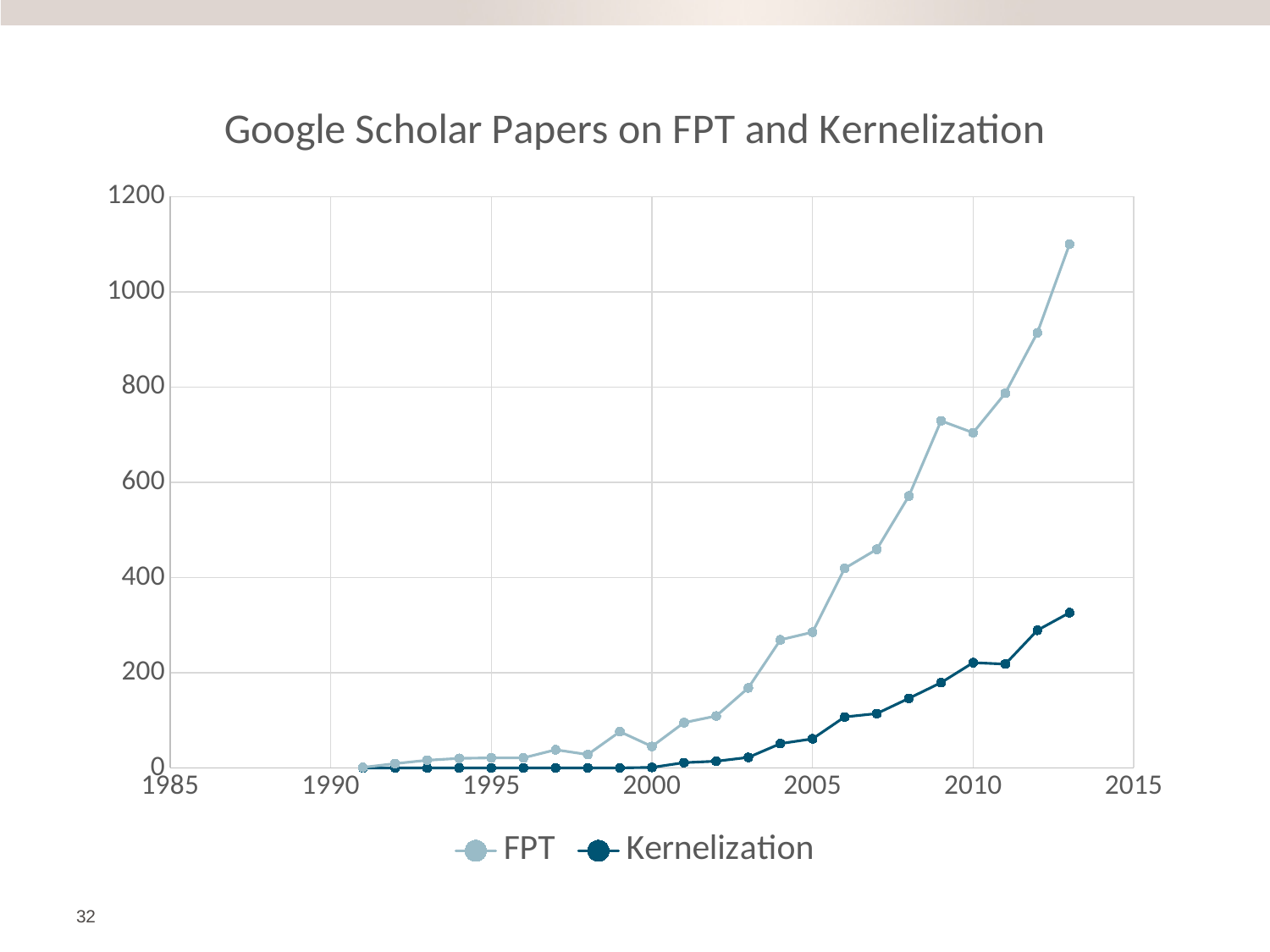
Is the FPT value for 2013 greater or less than 1000? greater What is the title of the chart? Google Scholar Papers on FPT and Kernelization What kind of chart is shown on the slide? line chart Is the Kernelization value for 2012 greater or less than 200? greater Do the FPT values generally rise or fall from 1991 to 2013? rise In 2013, which series has the larger value, FPT or Kernelization? FPT Is the FPT value for 2005 greater or less than 400? less How many series does the legend list? 2 Which series are listed in the legend? FPT and Kernelization In which year does the FPT series reach its highest value? 2013